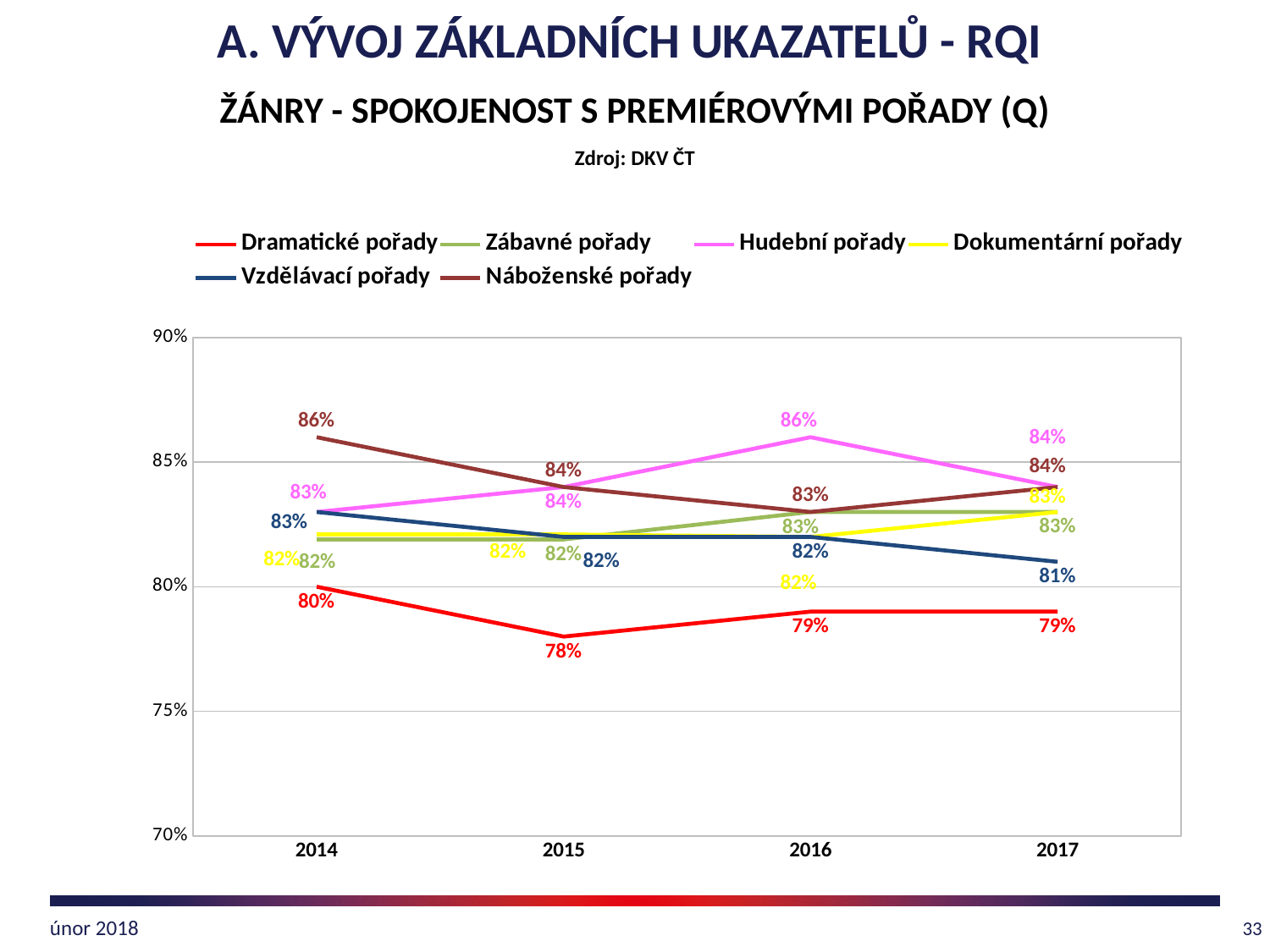
What is the value for Vzdělávací pořady in 2017? 81% How many years are shown on the x axis? 4 What type of chart is shown on the slide? line chart What is the difference between Náboženské pořady and Dramatické pořady in 2014? 6% Does the value for Vzdělávací pořady rise or fall from 2014 to 2017? fall How many series does the legend list? 6 What is the value for Dramatické pořady in 2015? 78% What is the value for Náboženské pořady in 2014? 86% Which is larger in 2016: Hudební pořady or Vzdělávací pořady? Hudební pořady Which series has the lowest value in 2017? Dramatické pořady What is the value for Hudební pořady in 2016? 86% Which series has the highest value in 2014? Náboženské pořady